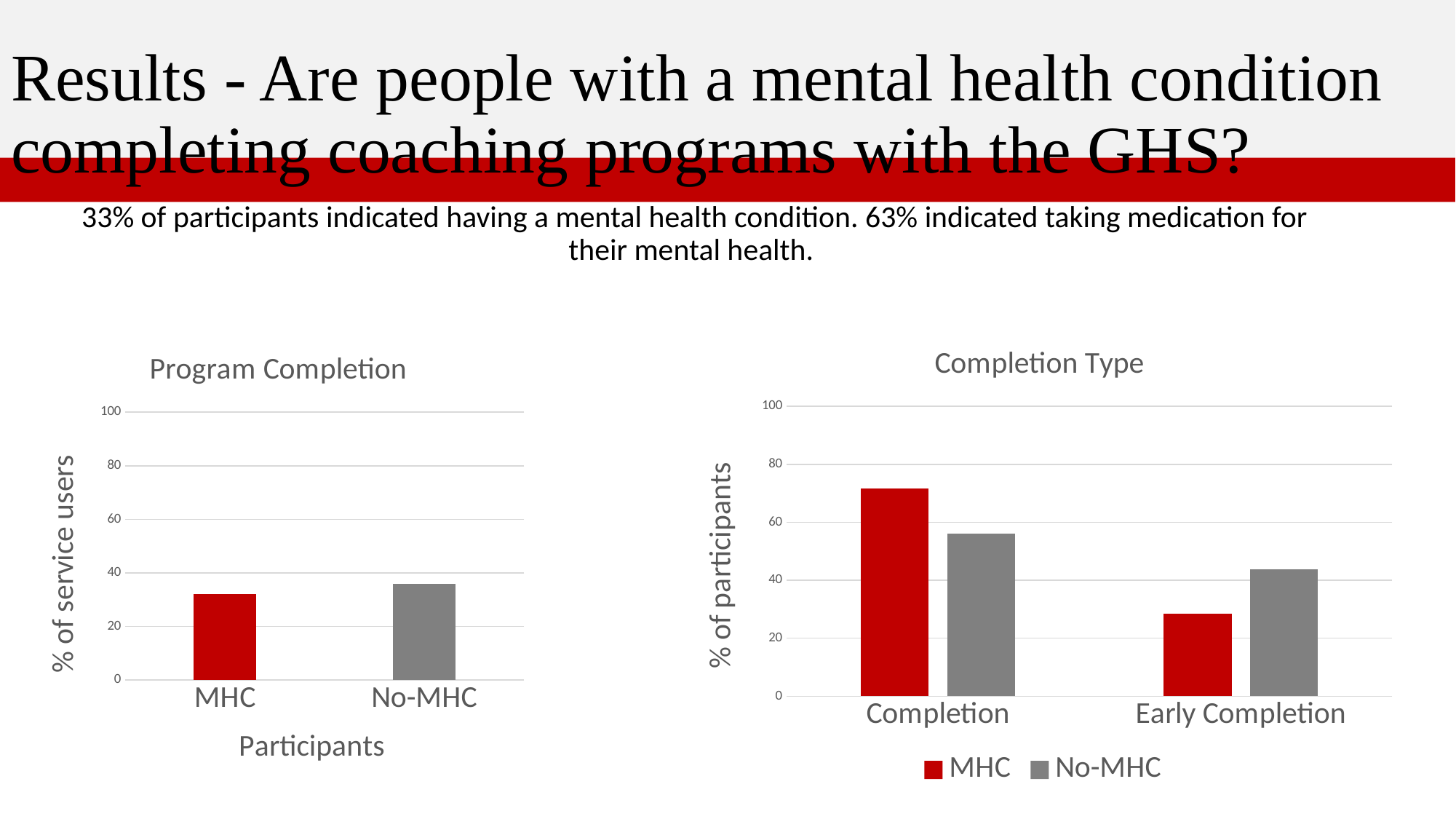
In the Completion Type chart, how many series does the legend list? 2 In the Completion Type chart, is the MHC value for Completion greater or less than 60? greater In the Completion Type chart, is the MHC value for Early Completion greater or less than 40? less What is the y-axis label of the Program Completion chart? % of service users In the Completion Type chart, which bar is the tallest? MHC for Completion In the Program Completion chart, is the value for MHC greater or less than 20? greater In the Completion Type chart, for Early Completion, which series has the larger value, MHC or No-MHC? No-MHC What type of chart is the Program Completion chart? bar chart In the Program Completion chart, how many categories are shown on the x axis? 2 In the Program Completion chart, which category has the higher value, MHC or No-MHC? No-MHC